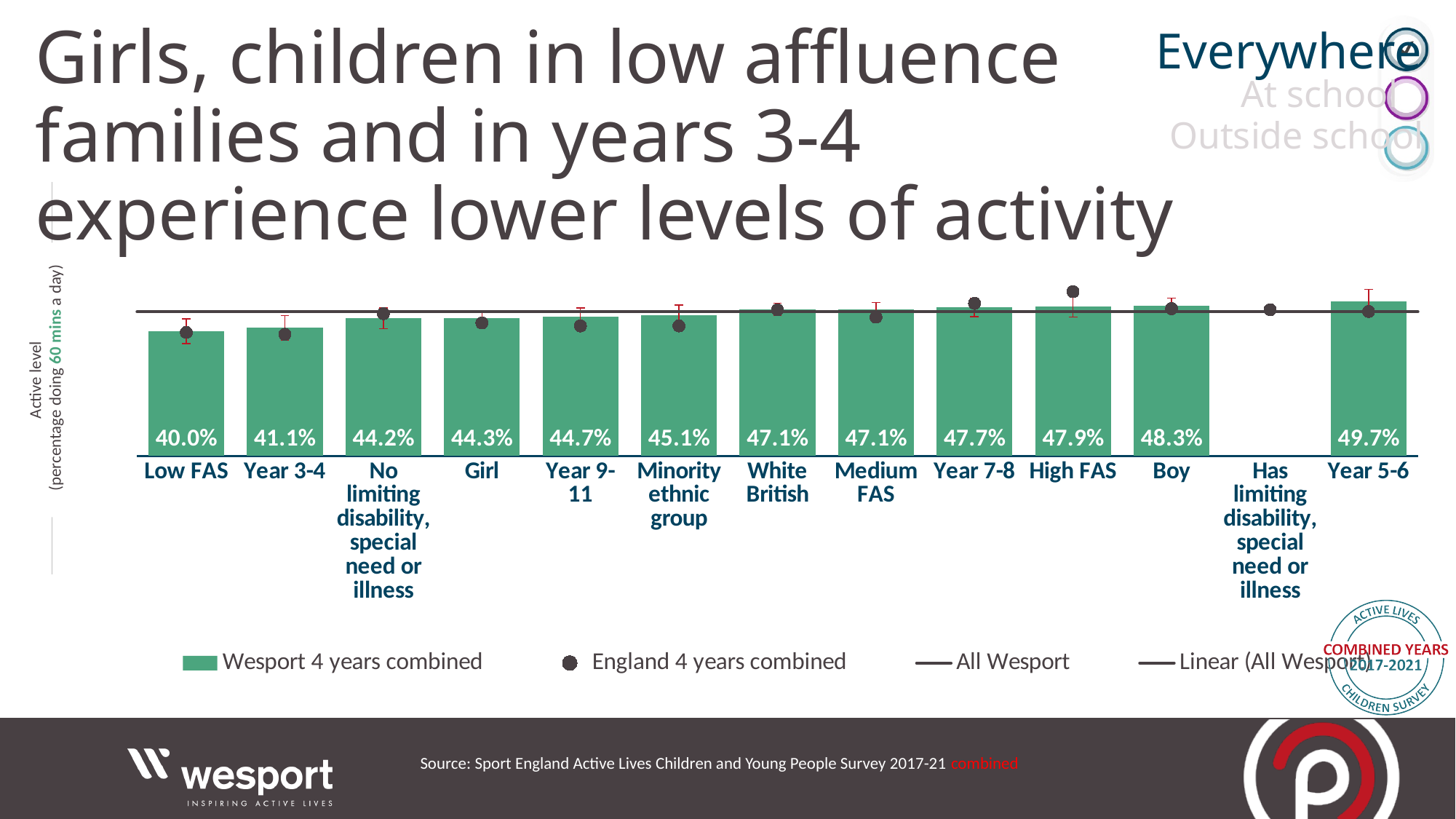
What is the difference between the Wesport values for Boy and Girl? 4.0 percentage points How many entries does the chart legend list? 4 Which category has the lowest Wesport 4 years combined value? Low FAS What is the Wesport 4 years combined value for Minority ethnic group? 45.1% Which has a higher Wesport 4 years combined value, Year 3-4 or Year 7-8? Year 7-8 Do the Wesport 4 years combined bar values rise or fall from left to right across the categories? Rise What kind of chart is shown on the slide? Bar chart What is the difference between the Wesport values for Year 5-6 and Low FAS? 9.7 percentage points What is the Wesport 4 years combined value for Low FAS? 40.0% Which category has the highest Wesport 4 years combined value? Year 5-6 What is the Wesport 4 years combined value for Girl? 44.3% What is the Wesport 4 years combined value for Year 5-6? 49.7%